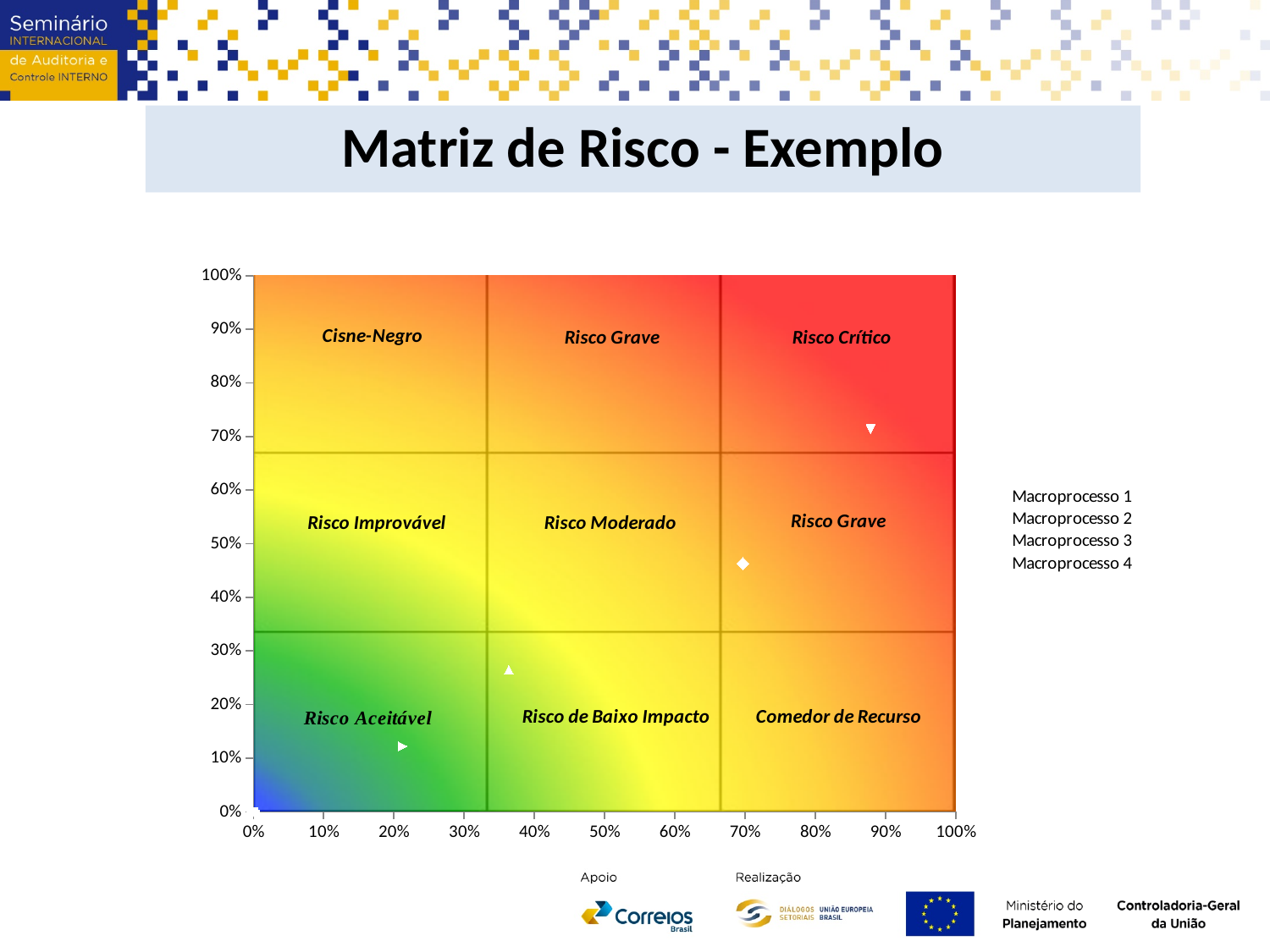
Is the y value of the right-pointing triangle marker greater or less than 20%? less How many series does the legend list? 4 Which plotted marker has the highest y value? the downward-pointing triangle Which has a larger x value, the diamond marker or the upward-pointing triangle marker? the diamond marker Is the x value of the upward-pointing triangle marker greater or less than 50%? less Is the x value of the downward-pointing triangle marker greater or less than 80%? greater What is the title of the slide containing the risk matrix? Matriz de Risco - Exemplo Which plotted marker has the lowest x value? the right-pointing triangle What kind of chart is shown on the slide? scatter chart In which labelled risk zone does the downward-pointing triangle marker lie? Risco Crítico How many data points are plotted on the risk matrix? 4